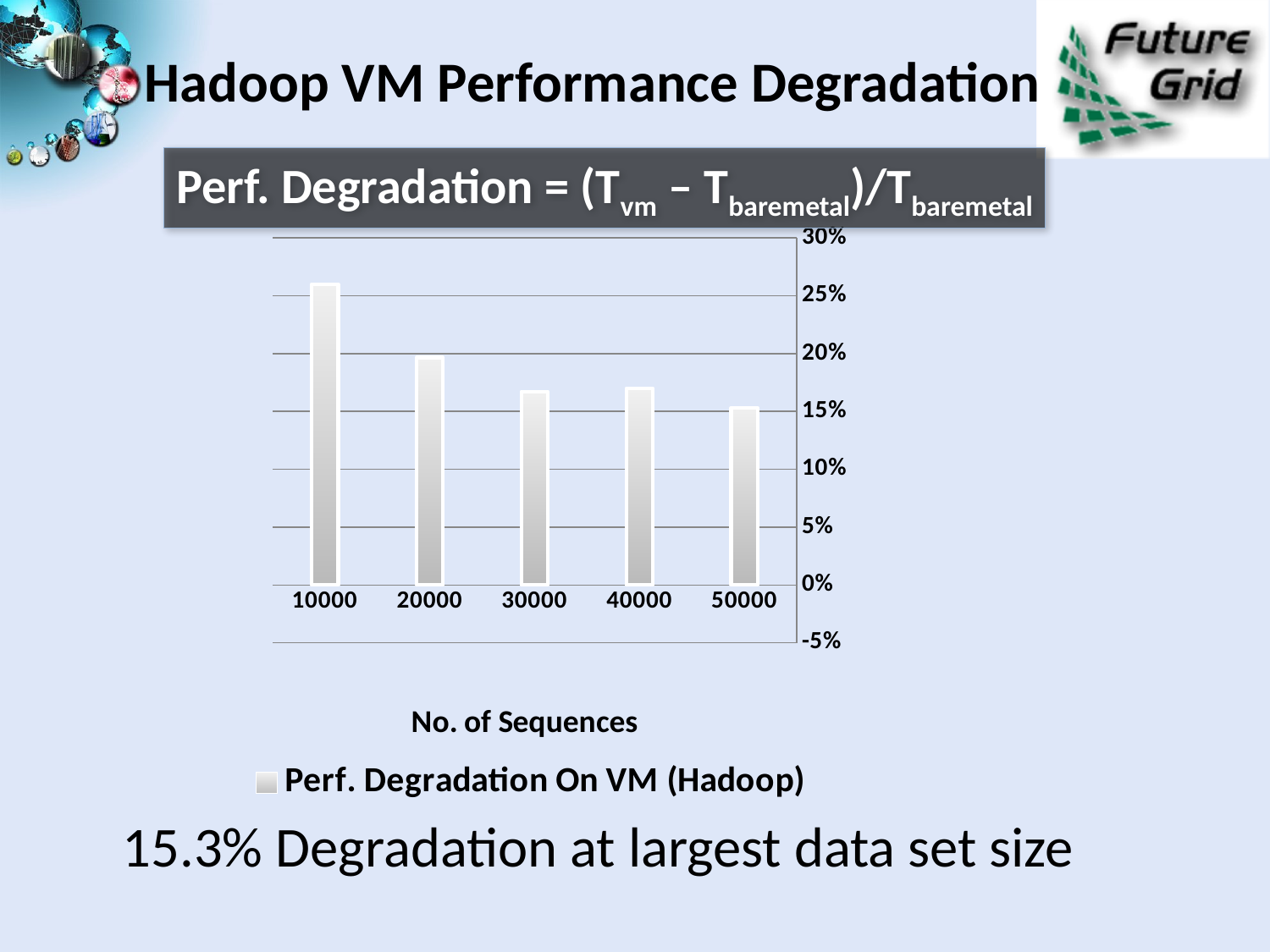
What kind of chart is shown on the slide? bar chart Is the value for 40000 sequences greater or less than 15%? greater What is the performance degradation at the largest data set size (50000 sequences)? 15.3% Is the value for 10000 sequences greater or less than 20%? greater Which number of sequences has the highest performance degradation? 10000 How many series does the legend list? 1 Is the value for 30000 sequences greater or less than 20%? less Which has the larger performance degradation, 10000 or 20000 sequences? 10000 How many categories (numbers of sequences) are plotted on the x axis? 5 Does the performance degradation generally rise or fall as the number of sequences increases? fall Which number of sequences has the lowest performance degradation? 50000